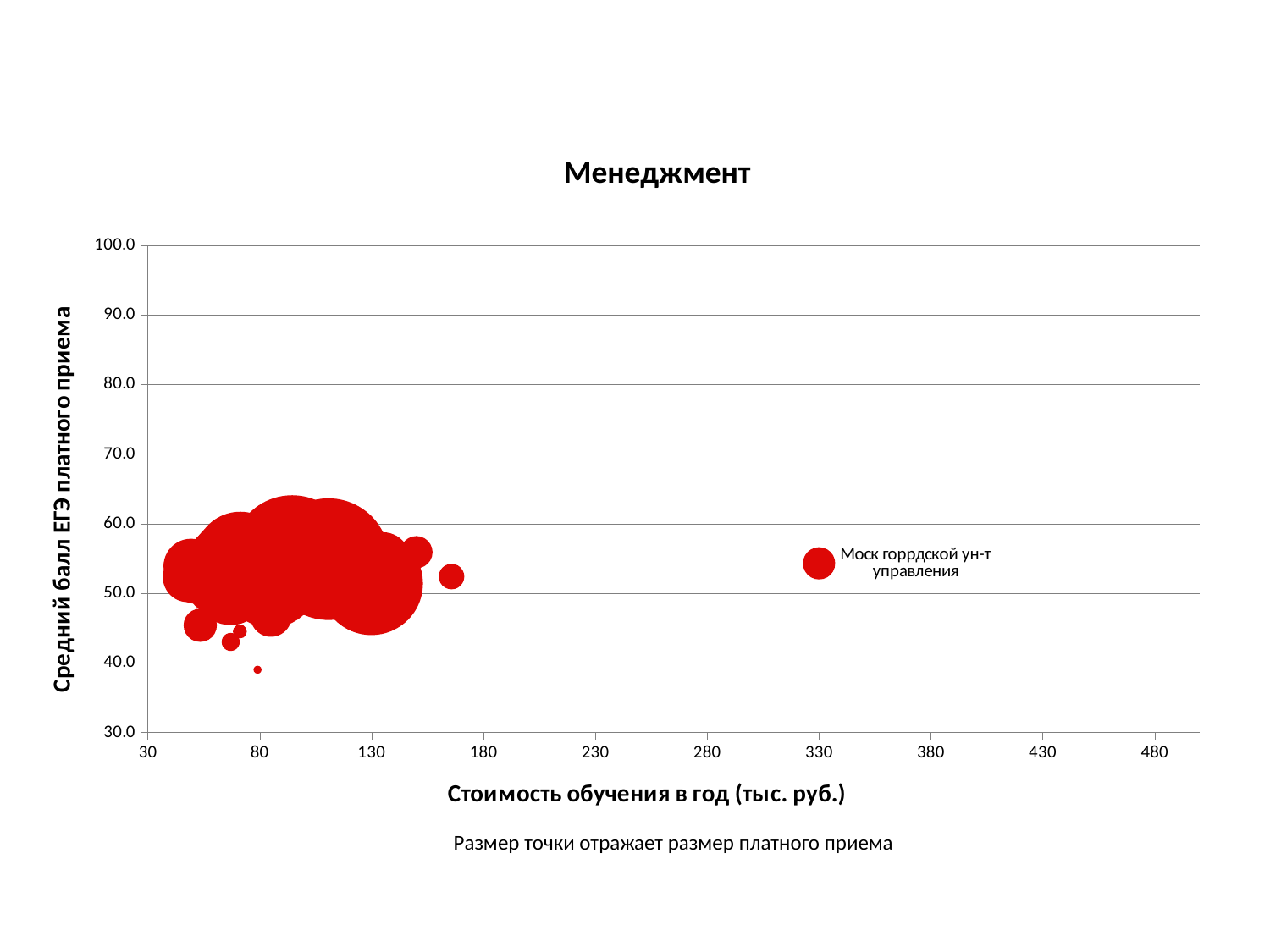
Is the tuition cost of the leftmost bubble greater or less than 80? less What is the title of the chart? Менеджмент Is the tuition cost of the rightmost bubble greater or less than 130? greater What kind of chart is shown on the slide? bubble chart Is the average score of the highest bubble greater or less than 70? less